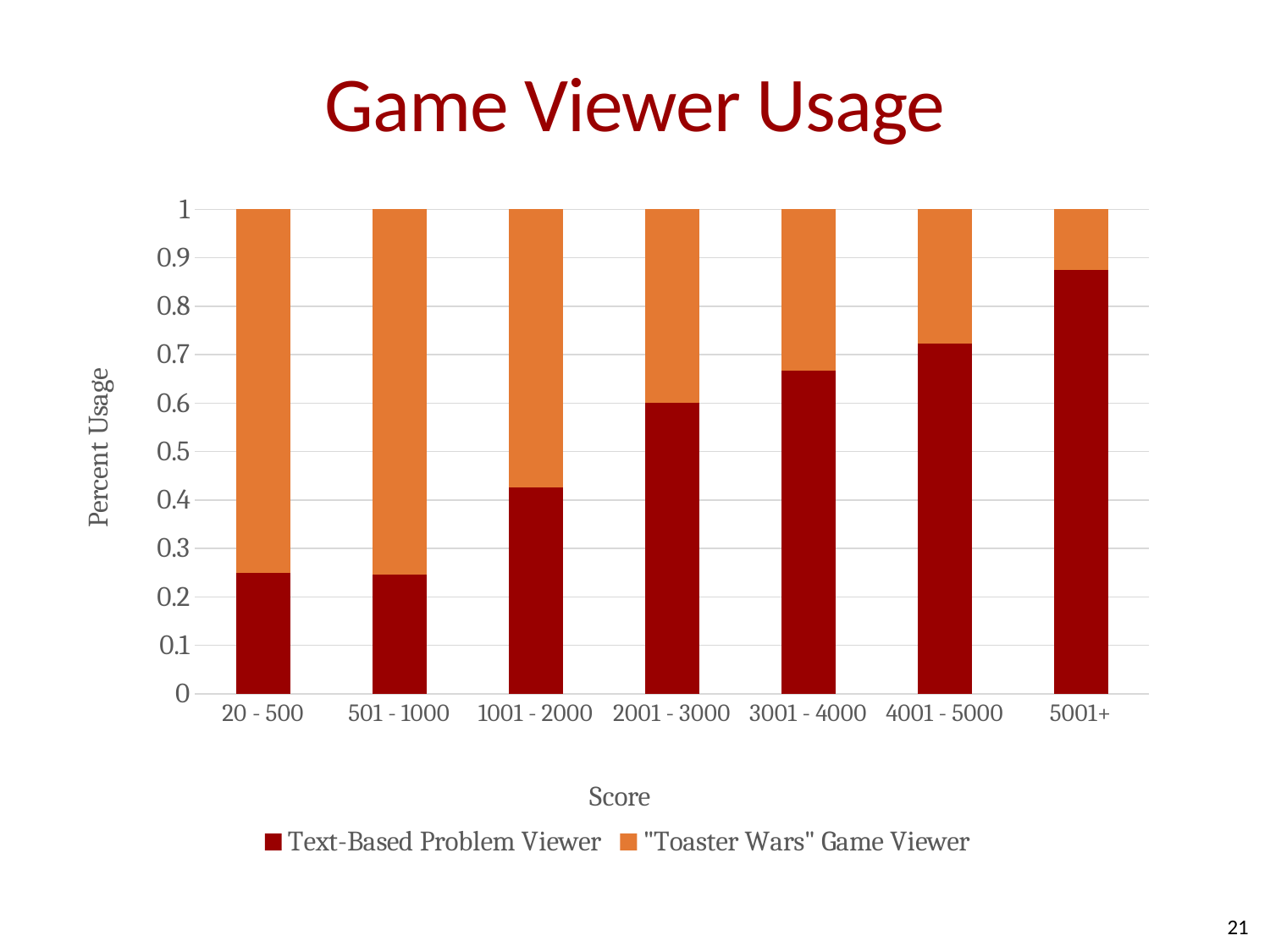
Which has the larger Text-Based Problem Viewer share, 1001 - 2000 or 2001 - 3000? 2001 - 3000 How many series does the legend list? 2 How many score categories are shown on the x axis? 7 Which score category has the lowest "Toaster Wars" Game Viewer share? 5001+ Is the Text-Based Problem Viewer value for 5001+ greater or less than 0.8? greater Does the Text-Based Problem Viewer share generally rise or fall as the score increases along the x axis? rise Is the Text-Based Problem Viewer value for 20 - 500 greater or less than 0.3? less What kind of chart is shown on the slide? Stacked bar chart Which score category has the highest Text-Based Problem Viewer share? 5001+ Is the Text-Based Problem Viewer value for 3001 - 4000 greater or less than 0.6? greater What is the label of the y axis? Percent Usage What is the title of the chart? Game Viewer Usage